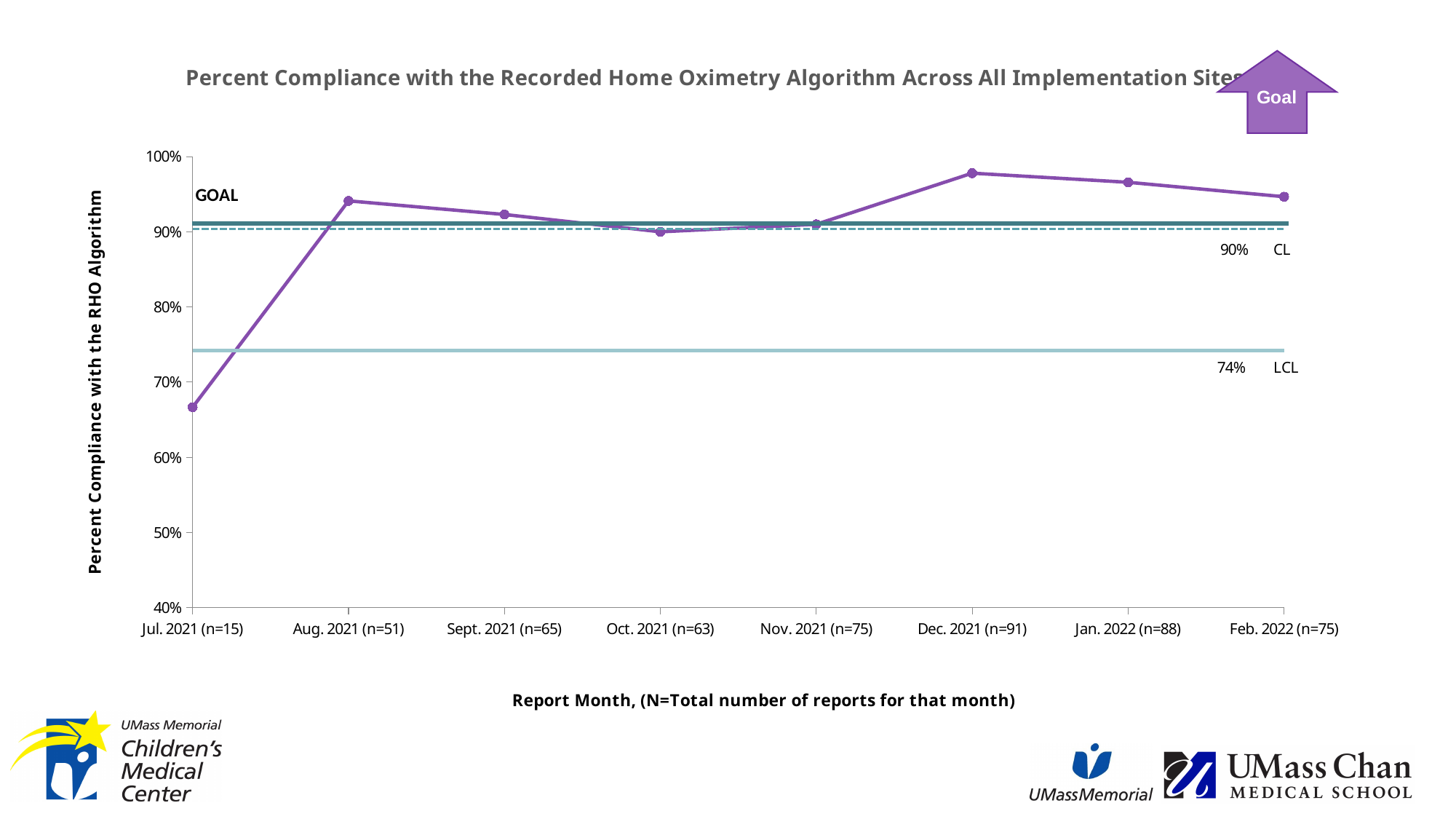
What value is labelled for the CL line? 90% What value is labelled for the LCL line? 74% Which report month has the highest percent compliance? Dec. 2021 (n=91) Does the percent compliance rise or fall from Dec. 2021 to Feb. 2022? fall What is the title of the chart? Percent Compliance with the Recorded Home Oximetry Algorithm Across All Implementation Sites Is the value for Aug. 2021 (n=51) greater or less than 90%? greater How many report months are plotted on the x axis? 8 Which is larger, the value for Jul. 2021 (n=15) or the value for Dec. 2021 (n=91)? Dec. 2021 (n=91) What kind of chart is shown on the slide? line chart Is the value for Dec. 2021 (n=91) greater or less than 90%? greater Which report month has the lowest percent compliance? Jul. 2021 (n=15) Is the value for Jul. 2021 (n=15) greater or less than 70%? less